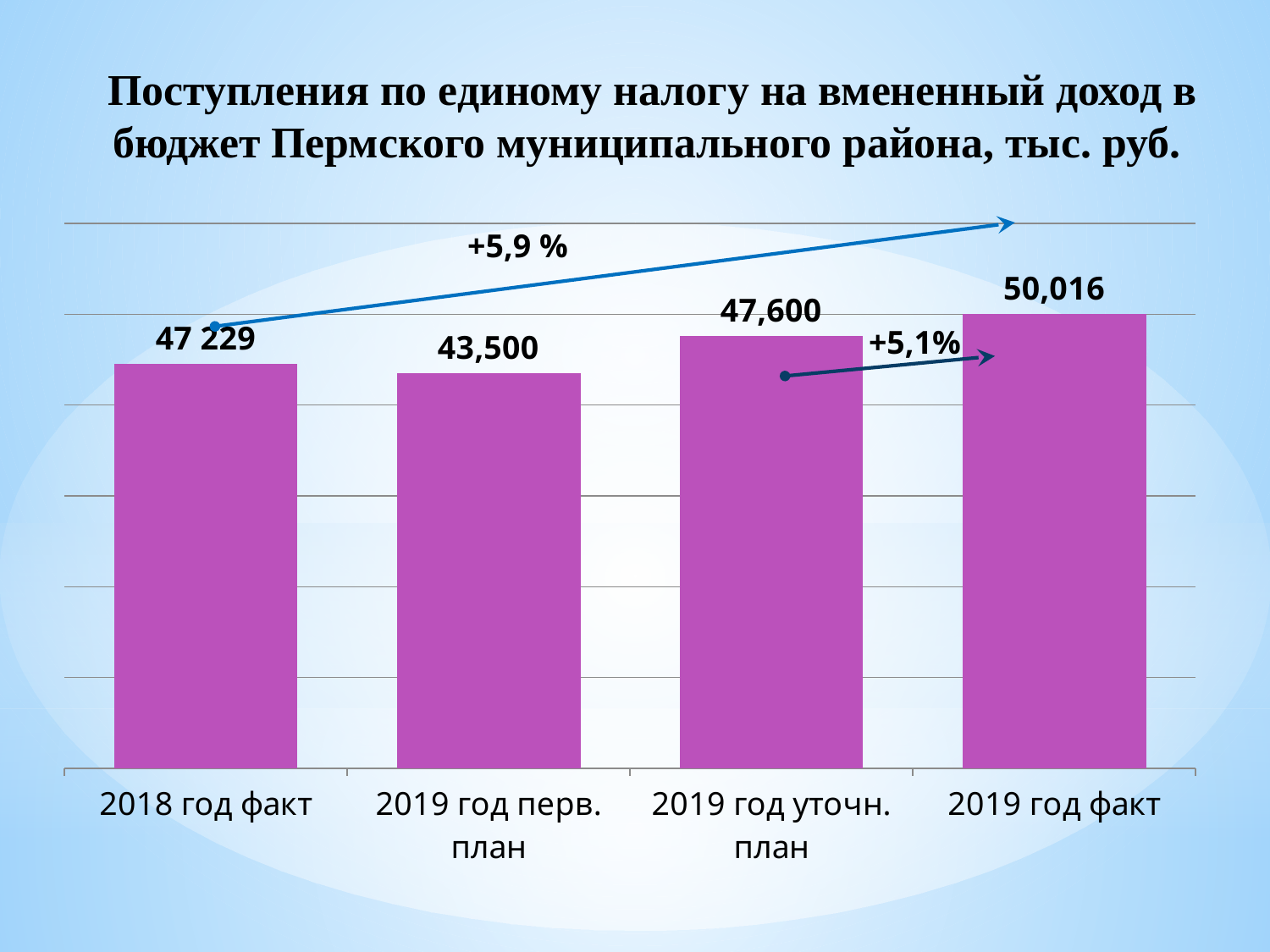
What is the difference between the values for 2019 год факт and 2019 год уточн. план? 2,416 What is the value for 2019 год перв. план? 43,500 What is the value for 2019 год уточн. план? 47,600 What is the value for 2018 год факт? 47 229 Which is larger, the value for 2018 год факт or the value for 2019 год перв. план? 2018 год факт Which category has the highest value? 2019 год факт What is the value for 2019 год факт? 50,016 What kind of chart is shown on the slide? Bar chart Which category has the lowest value? 2019 год перв. план What percentage change is annotated between 2019 год уточн. план and 2019 год факт? +5,1% How many categories are shown on the chart? 4 What is the difference between the values for 2019 год уточн. план and 2019 год перв. план? 4,100